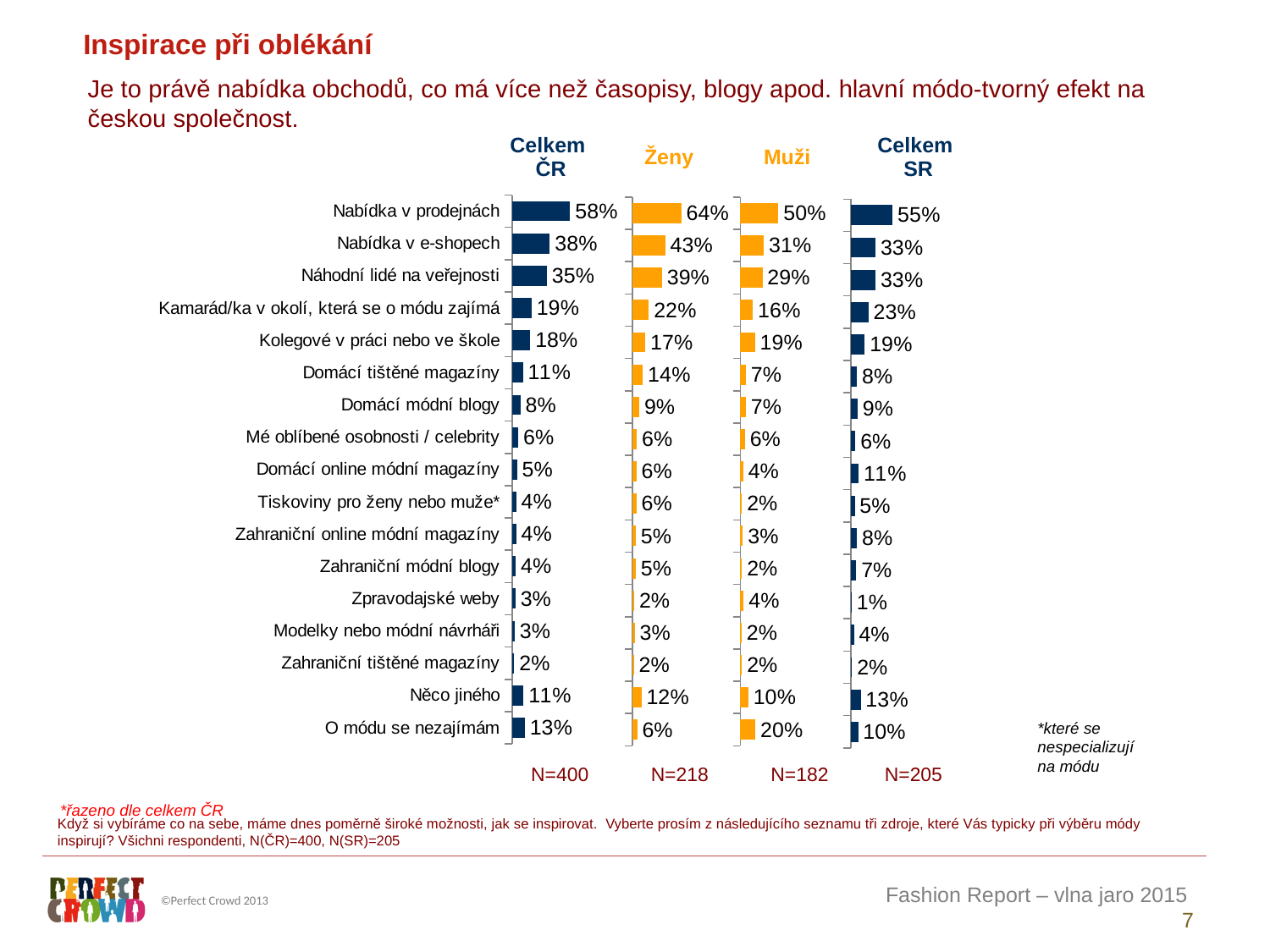
For Kolegové v práci nebo ve škole, which is larger: the Ženy value or the Muži value? Muži In the Muži chart, what is the value for O módu se nezajímám? 20% In the Celkem ČR chart, what is the value for Nabídka v prodejnách? 58% In the Celkem SR chart, which category has the lowest value? Zpravodajské weby In the Ženy chart, what is the value for Nabídka v e-shopech? 43% In the Celkem SR chart, what is the value for Domácí online módní magazíny? 11% What is the difference between the Ženy and Muži values for Nabídka v prodejnách? 14 percentage points What type of chart is used for the Celkem ČR data? Bar chart How many categories are listed in the Celkem ČR chart? 17 What is the difference between the Celkem ČR and Celkem SR values for Nabídka v e-shopech? 5 percentage points What is the sample size (N) shown under the Ženy chart? N=218 In the Muži chart, which category has the highest value? Nabídka v prodejnách